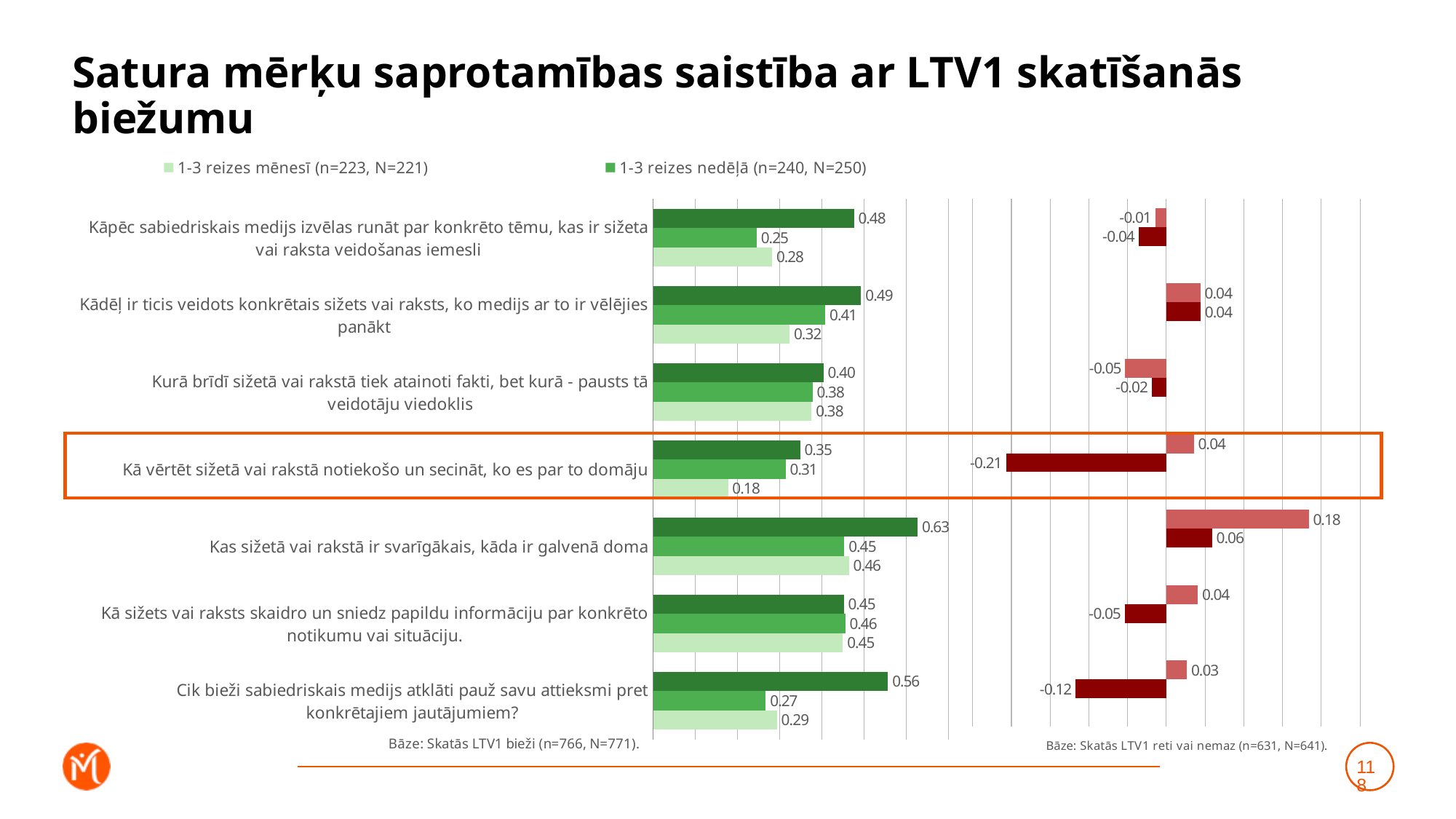
What is the highest value shown in the left chart? 0.63 How many series does the legend at the top of the slide list? 2 What kind of chart is shown on the left side of the slide? bar chart In the right chart, what is the largest positive value shown? 0.18 In the left chart, what is the difference between the '1-3 reizes mēnesī' value and the '1-3 reizes nedēļā' value for 'Kāpēc sabiedriskais medijs izvēlas runāt par konkrēto tēmu, kas ir sižeta vai raksta veidošanas iemesli'? 0.03 In the left chart, what is the value for '1-3 reizes mēnesī' for 'Cik bieži sabiedriskais medijs atklāti pauž savu attieksmi pret konkrētajiem jautājumiem?'? 0.29 In the left chart, which is larger for 'Kas sižetā vai rakstā ir svarīgākais, kāda ir galvenā doma': the '1-3 reizes nedēļā' value or the '1-3 reizes mēnesī' value? 1-3 reizes mēnesī How many categories (questions) are listed on the left chart? 7 Which category on the slide is highlighted with an orange box? Kā vērtēt sižetā vai rakstā notiekošo un secināt, ko es par to domāju What is the lowest value shown in the right chart? -0.21 In the left chart, what is the value for '1-3 reizes mēnesī' for 'Kā vērtēt sižetā vai rakstā notiekošo un secināt, ko es par to domāju'? 0.18 In the left chart, what is the value for '1-3 reizes nedēļā' for 'Kādēļ ir ticis veidots konkrētais sižets vai raksts, ko medijs ar to ir vēlējies panākt'? 0.41